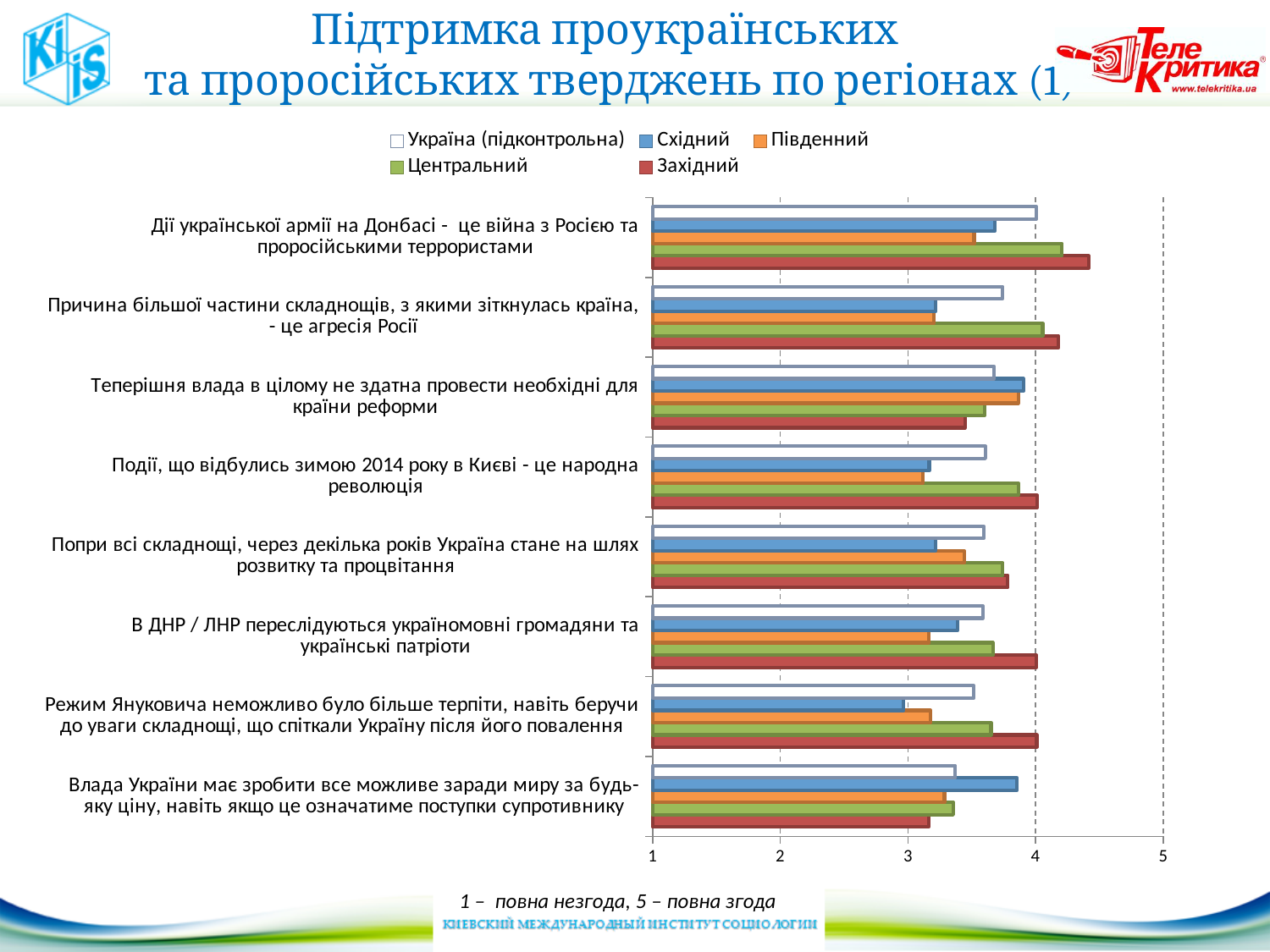
Is the value for Західний on the statement "Дії української армії на Донбасі - це війна з Росією та проросійськими террористами" greater or less than 4? greater For the statement "Влада України має зробити все можливе заради миру за будь-яку ціну...", which is larger: Східний or Західний? Східний What kind of chart is shown on the slide? bar chart Is the value for Західний on the statement "Теперішня влада в цілому не здатна провести необхідні для країни реформи" greater or less than 4? less For the statement "Режим Януковича неможливо було більше терпіти...", which region has the lowest value? Східний For the statement "Дії української армії на Донбасі - це війна з Росією та проросійськими террористами", which region has the highest value? Західний Is the value for Західний on the statement "Влада України має зробити все можливе заради миру за будь-яку ціну..." greater or less than 4? less How many statements (categories) are plotted on the chart? 8 What is the range of the horizontal axis on the chart? 1 to 5 For the statement "Влада України має зробити все можливе заради миру за будь-яку ціну...", which region has the highest value? Східний How many series does the legend list? 5